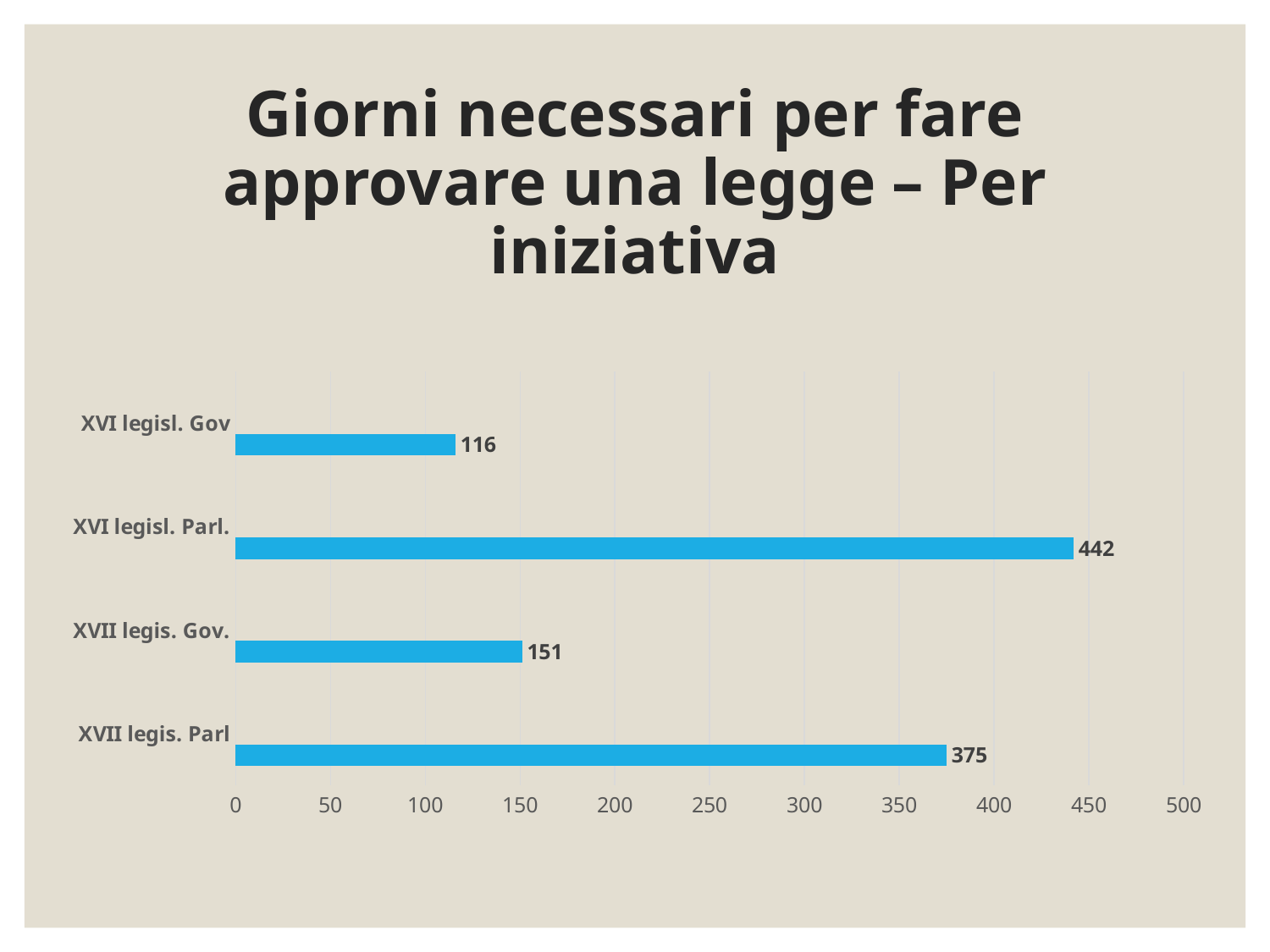
What is the difference between the values for XVI legisl. Parl. and XVII legis. Parl? 67 What is the value for XVII legis. Gov.? 151 What kind of chart is shown on the slide? Bar chart What is the value for XVII legis. Parl? 375 What is the title of the chart? Giorni necessari per fare approvare una legge – Per iniziativa What is the difference between the values for XVII legis. Gov. and XVI legisl. Gov? 35 How many categories are shown in the chart? 4 What is the value for XVI legisl. Parl.? 442 Which category has the highest value? XVI legisl. Parl. What is the value for XVI legisl. Gov? 116 Which category has the lowest value? XVI legisl. Gov Which is larger, the value for XVII legis. Gov. or the value for XVI legisl. Gov? XVII legis. Gov.